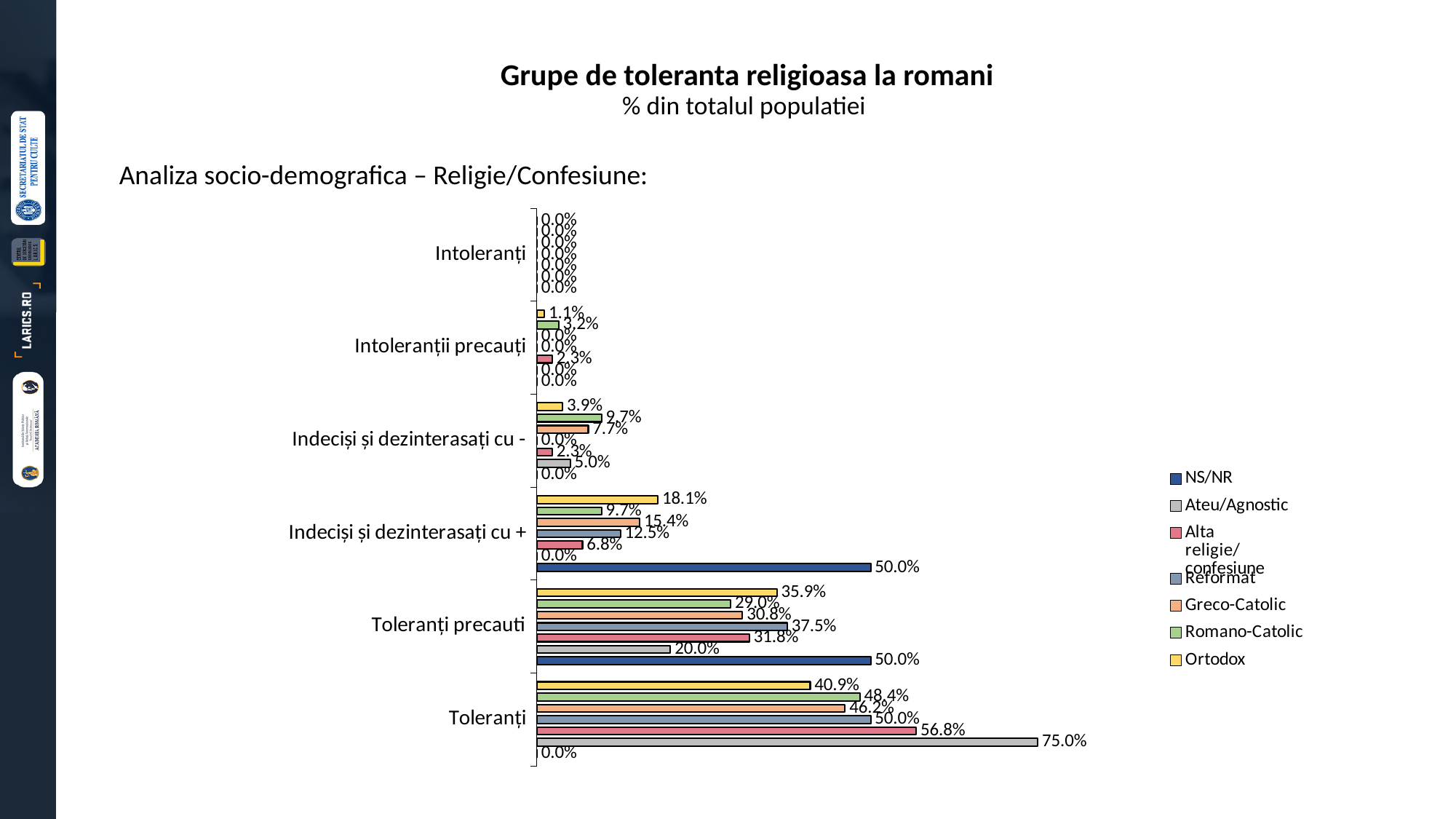
What type of chart is shown on the slide? bar chart What is the value for Romano-Catolic in the Intoleranții precauți group? 3.2% What is the value for Greco-Catolic in the Indeciși și dezinterasați cu + group? 15.4% What is the value for Ortodox in the Toleranți precauti group? 35.9% In the Toleranți precauti group, which is larger: the Reformat value or the Romano-Catolic value? Reformat What is the subtitle shown under the chart title? % din totalul populatiei How many tolerance groups (categories) are shown on the vertical axis? 6 Which series has the highest value in the Toleranți group? Ateu/Agnostic How many series does the legend list? 7 Which series has the lowest non-zero value in the Toleranți precauti group? Ateu/Agnostic What is the value for Ateu/Agnostic in the Toleranți group? 75.0% What is the difference between the Alta religie/confesiune value and the Ortodox value in the Toleranți group? 15.9%